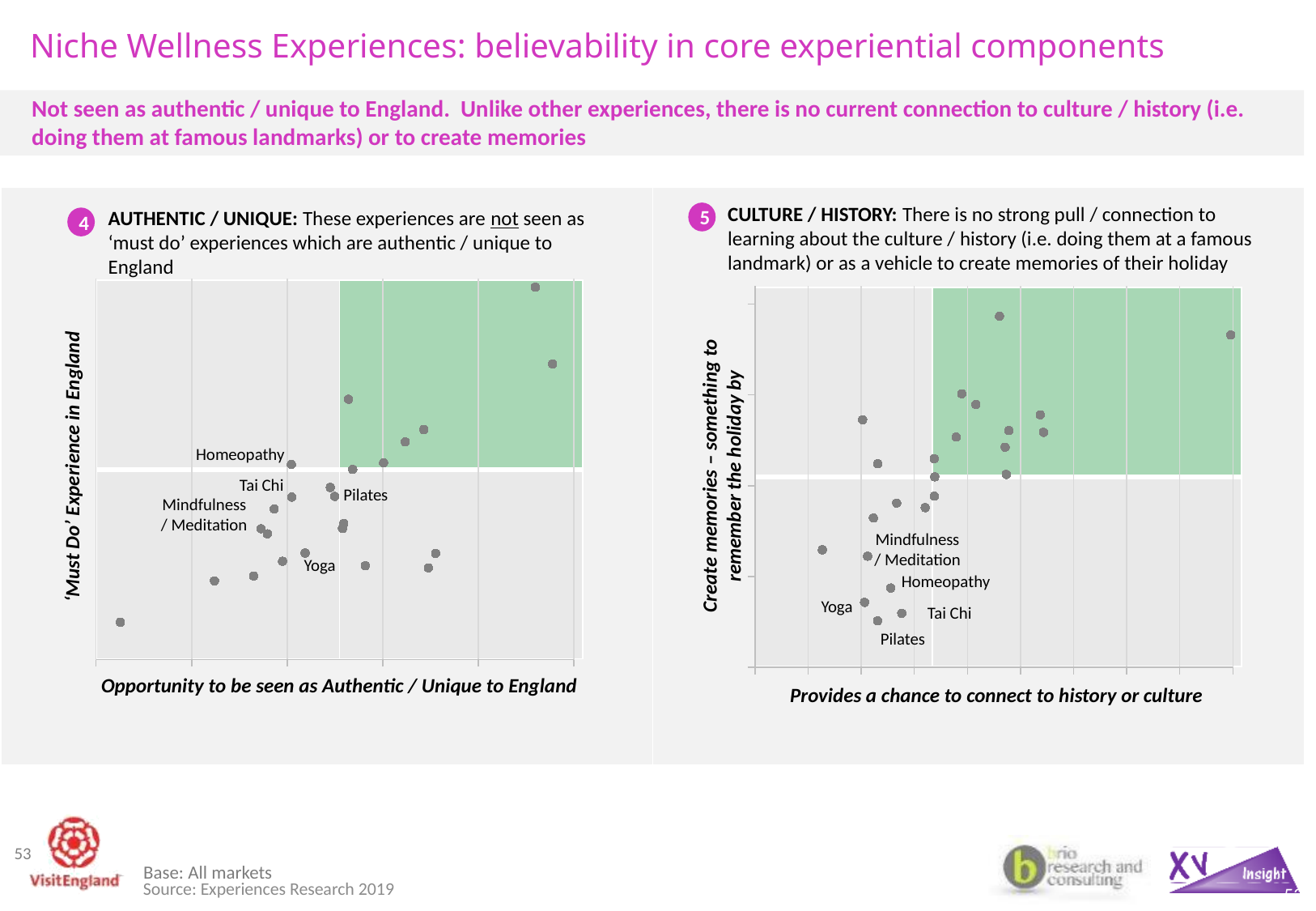
On the left chart, which is higher on the 'Must Do' axis: Homeopathy or Yoga? Homeopathy On the right chart, which labelled experience has the highest 'Create memories' value? Mindfulness / Meditation On the right chart, which is further right on the 'Provides a chance to connect to history or culture' axis: Yoga or Tai Chi? Tai Chi On the right chart, how many points are labelled with an experience name? 5 What is the y-axis title of the left chart? 'Must Do' Experience in England On the left chart, which labelled experience has the lowest 'Must Do' Experience in England value? Yoga What is the x-axis title of the right chart? Provides a chance to connect to history or culture What kind of chart is the left chart, titled 'Opportunity to be seen as Authentic / Unique to England' on its x axis? Scatter chart On the right chart, which is higher on the 'Create memories' axis: Mindfulness / Meditation or Homeopathy? Mindfulness / Meditation On the left chart, which labelled experience has the highest 'Must Do' Experience in England value? Homeopathy What kind of chart is the right chart, with the x axis 'Provides a chance to connect to history or culture'? Scatter chart On the left chart, how many points are labelled with an experience name? 5